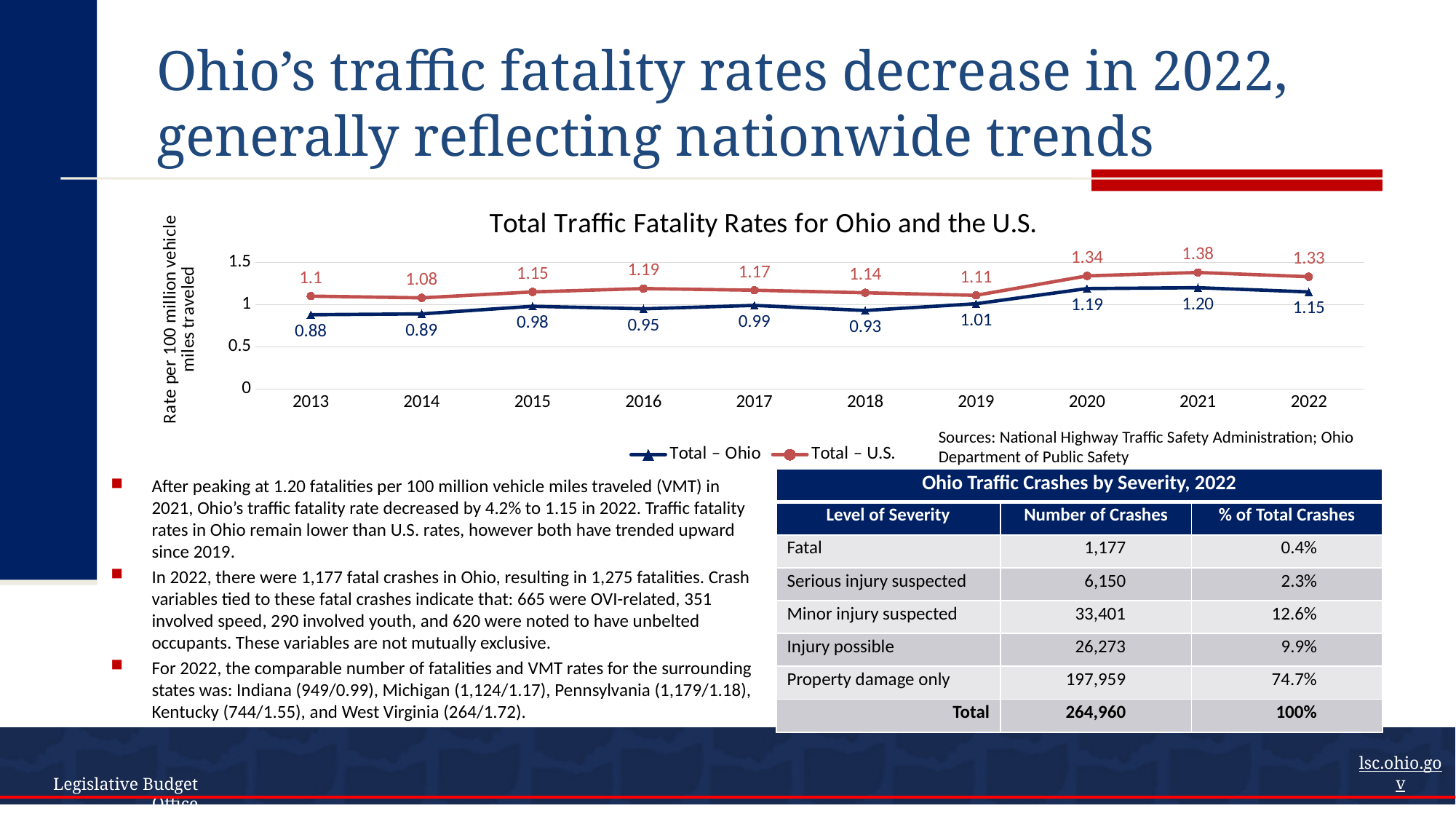
In which year is the Total – U.S. rate lowest? 2014 What is the Total – Ohio value for 2013? 0.88 What is the title of the chart? Total Traffic Fatality Rates for Ohio and the U.S. What kind of chart is shown on the slide? Line chart What is the Total – U.S. value for 2014? 1.08 What is the Total – Ohio value for 2022? 1.15 How many years are shown on the x axis of the chart? 10 How many series does the chart's legend list? 2 In which year is the Total – Ohio rate highest? 2021 What is the Total – U.S. value for 2021? 1.38 What is the difference between the Total – U.S. and Total – Ohio values in 2022? 0.18 Which is larger in 2019, the Total – Ohio value or the Total – U.S. value? Total – U.S.